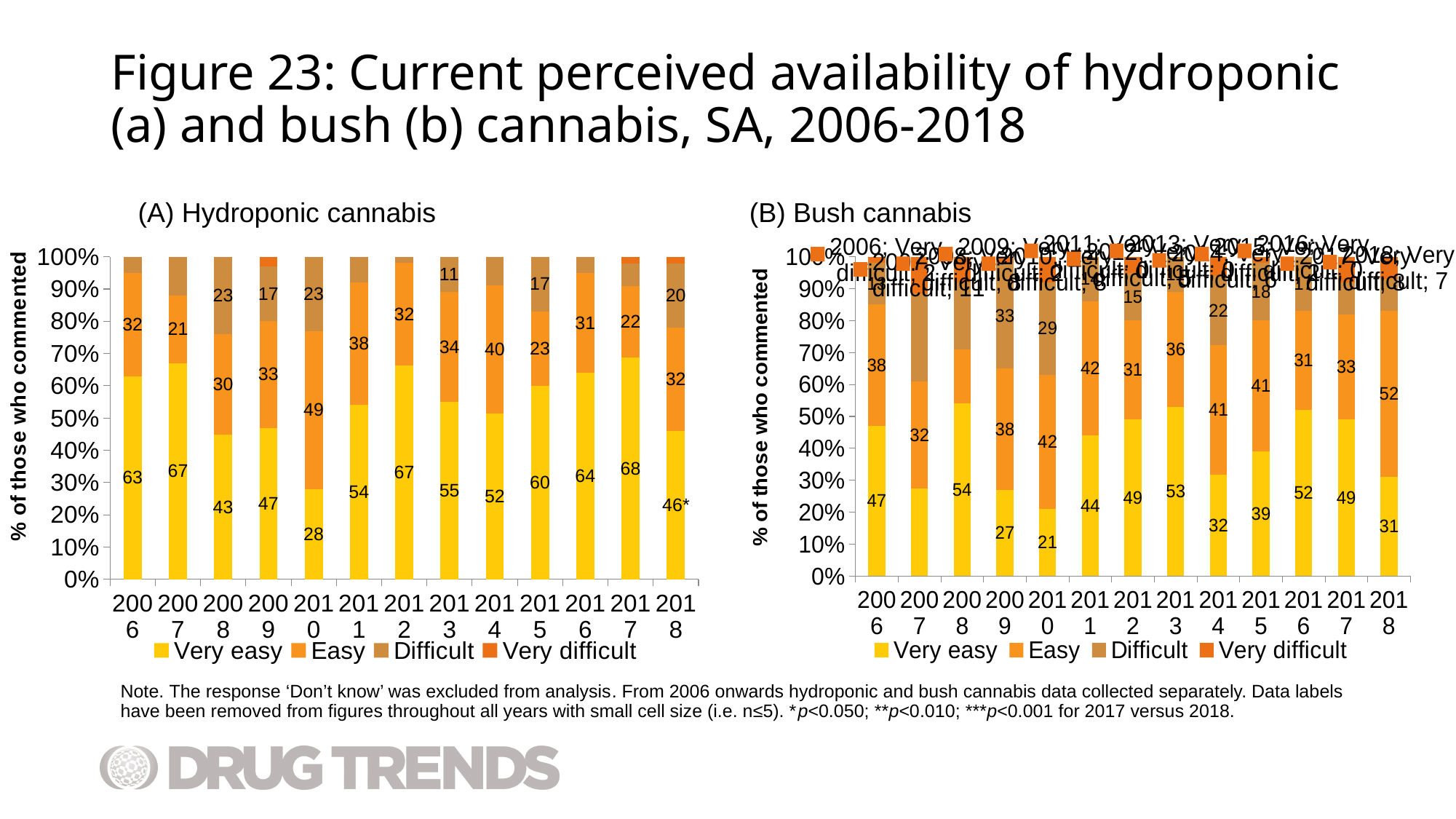
What kind of chart is chart (A) Hydroponic cannabis? Stacked bar chart How many years are shown on the x axis of chart (B) Bush cannabis? 13 In chart (A) Hydroponic cannabis, what is the 'Easy' value for 2014? 40 In chart (A) Hydroponic cannabis, what is the difference between the 'Very easy' values for 2017 and 2018? 22 In chart (B) Bush cannabis, what is the 'Easy' value for 2018? 52 In chart (A) Hydroponic cannabis, is the 'Easy' value larger in 2010 or 2011? 2010 In chart (B) Bush cannabis, which year has the lowest 'Very easy' value? 2010 How many series does the legend of chart (A) Hydroponic cannabis list? 4 In chart (A) Hydroponic cannabis, what percentage reported 'Very easy' in 2010? 28 In chart (A) Hydroponic cannabis, which year has the lowest 'Very easy' value? 2010 In chart (A) Hydroponic cannabis, which year has the highest 'Very easy' value? 2017 In chart (B) Bush cannabis, what is the 'Very easy' value for 2008? 54